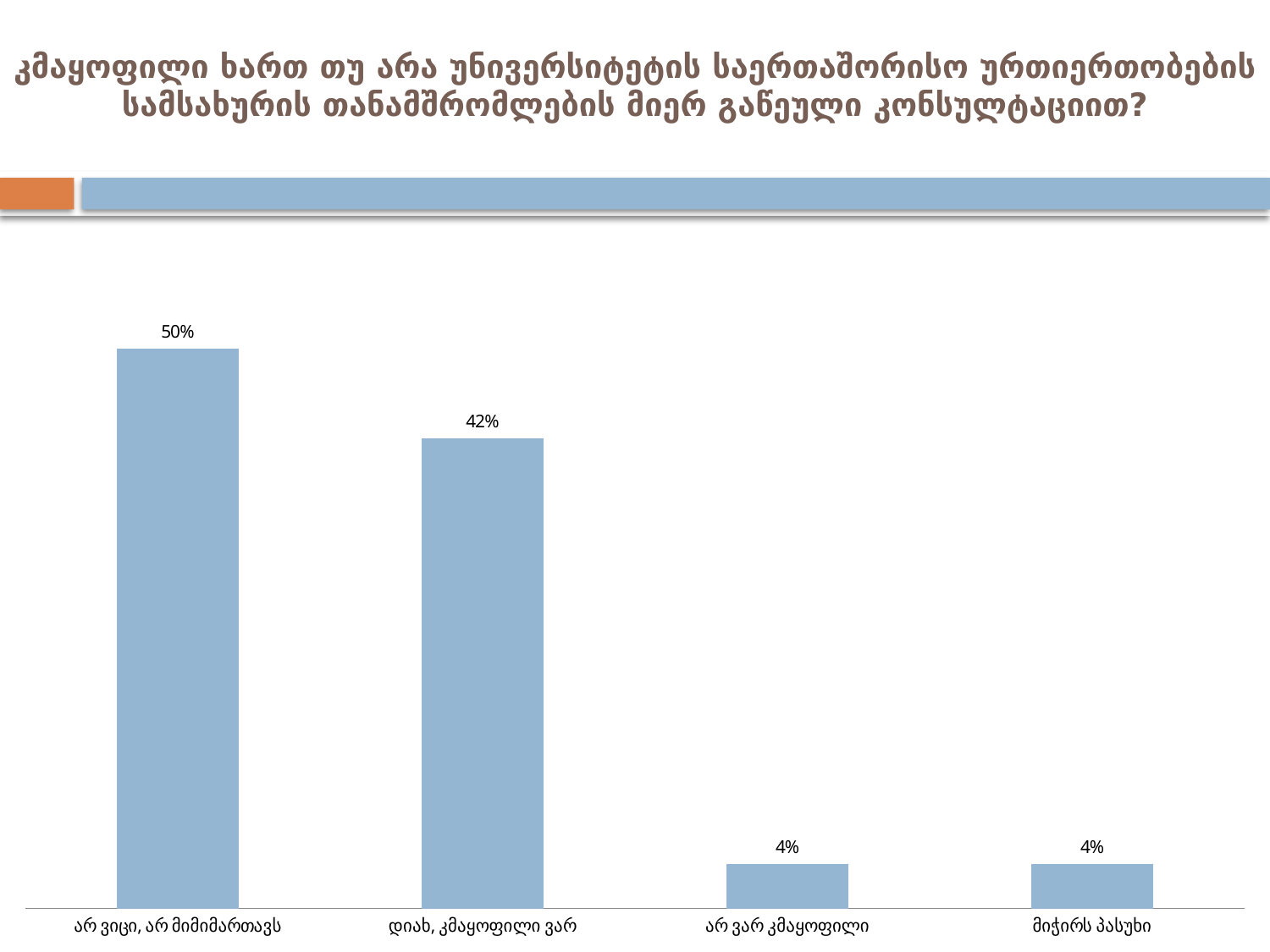
Do the values rise or fall from left to right across the categories? fall What value is shown for the category "მიჭირს პასუხი"? 4% Which is larger, the value for "არ ვიცი, არ მიმიმართავს" or the value for "დიახ, კმაყოფილი ვარ"? არ ვიცი, არ მიმიმართავს Which category has the highest value? არ ვიცი, არ მიმიმართავს What value is shown for the category "დიახ, კმაყოფილი ვარ"? 42% Which is larger, the value for "დიახ, კმაყოფილი ვარ" or the value for "მიჭირს პასუხი"? დიახ, კმაყოფილი ვარ What is the difference between the values for "არ ვიცი, არ მიმიმართავს" and "დიახ, კმაყოფილი ვარ"? 8% How many categories are shown on the chart? 4 What value is shown for the category "არ ვიცი, არ მიმიმართავს"? 50% What value is shown for the category "არ ვარ კმაყოფილი"? 4% What kind of chart is shown on the slide? bar chart What is the difference between the values for "დიახ, კმაყოფილი ვარ" and "არ ვარ კმაყოფილი"? 38%